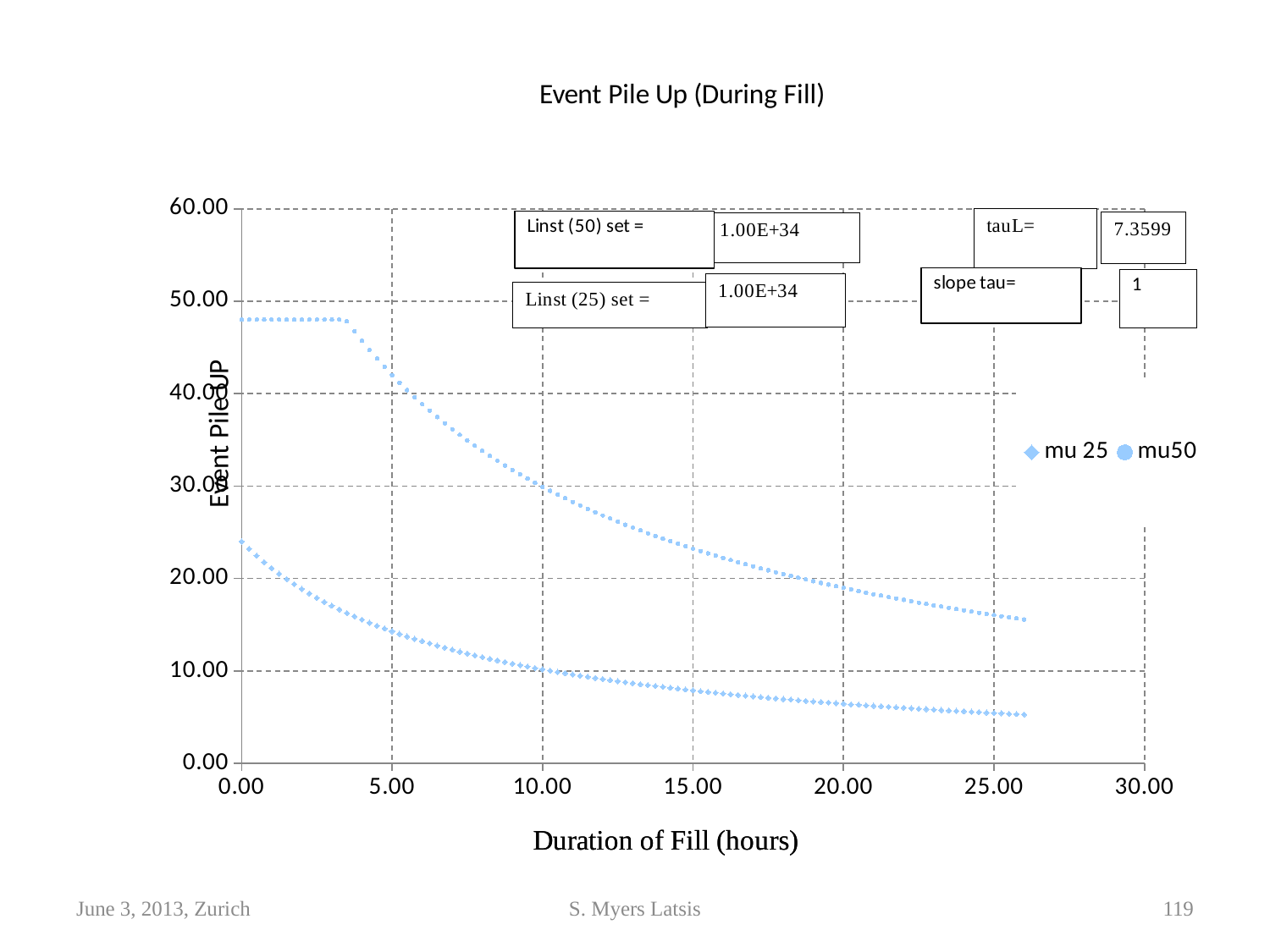
Which series has the higher value at 0.00 hours? mu50 What kind of chart is shown on the slide? scatter chart At 10.00 hours, which series has the larger value, mu 25 or mu50? mu50 What are the names of the two series in the legend? mu 25 and mu50 How many series does the chart legend list? 2 What is the title of the chart? Event Pile Up (During Fill) Do the mu50 values rise or fall as the duration of fill increases? fall Do the mu 25 values rise or fall as the duration of fill increases? fall Is the mu50 value at 0.00 hours greater or less than 40.00? greater Is the mu50 value at 25.00 hours greater or less than 20.00? less Is the mu 25 value at 25.00 hours greater or less than 10.00? less